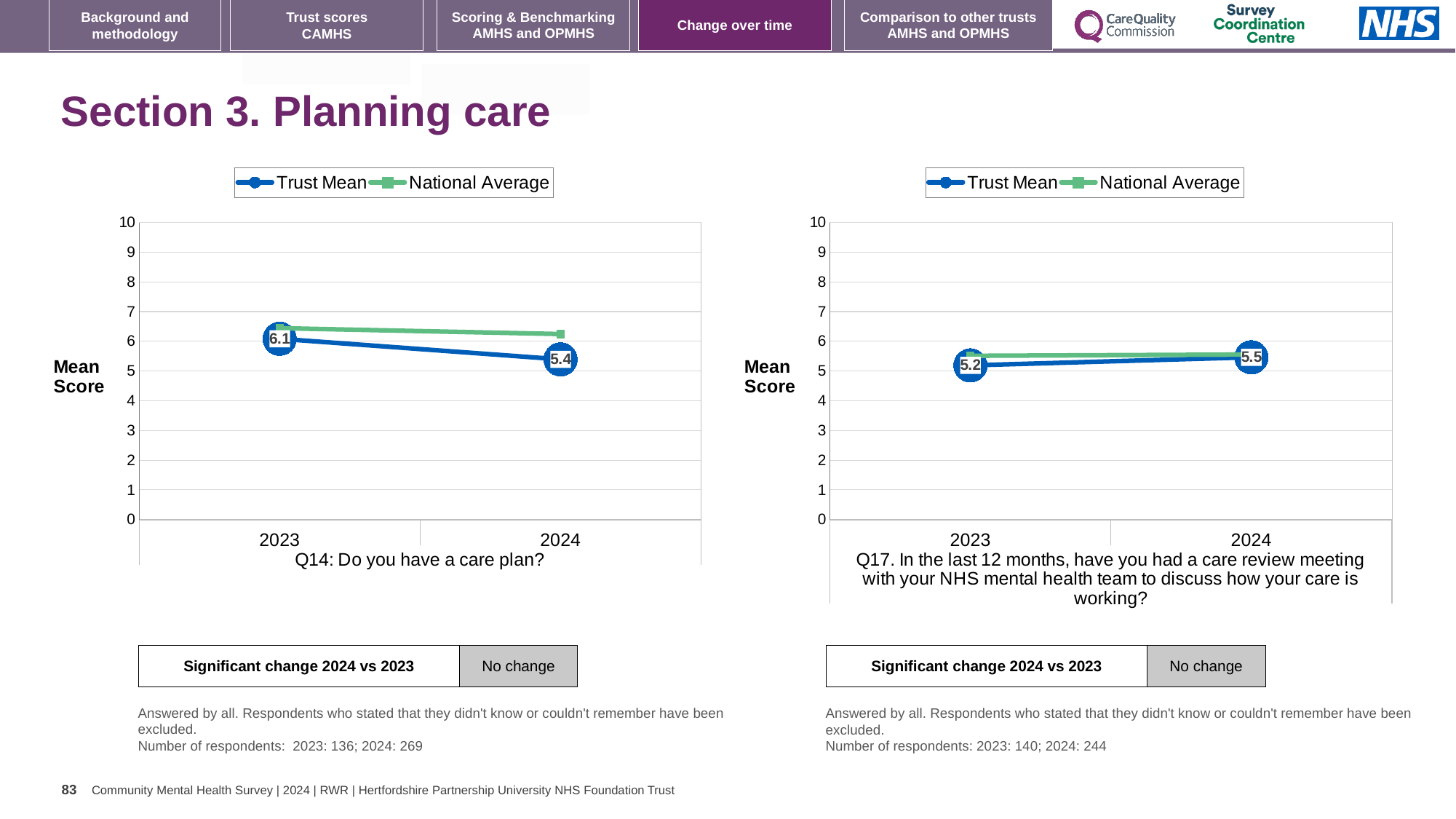
On the Q14 chart (left), what is the Trust Mean score for 2024? 5.4 On the Q17 chart (right), what is the difference between the Trust Mean in 2024 and 2023? 0.3 On the Q14 chart (left), by how much did the Trust Mean change from 2023 to 2024? 0.7 On the Q14 chart (left), is the National Average value for 2023 greater or less than 5? greater On the Q17 chart (right), what is the Trust Mean score for 2023? 5.2 On the Q14 chart (left), what is the Trust Mean score for 2023? 6.1 On the Q17 chart (right), does the Trust Mean rise or fall from 2023 to 2024? rise How many series does the legend list on the Q17 chart (right)? 2 On the Q14 chart (left), which year has the higher Trust Mean, 2023 or 2024? 2023 On the Q14 chart (left), does the Trust Mean rise or fall from 2023 to 2024? fall What kind of chart is used on the Q14 chart (left)? line chart On the Q17 chart (right), what is the Trust Mean score for 2024? 5.5